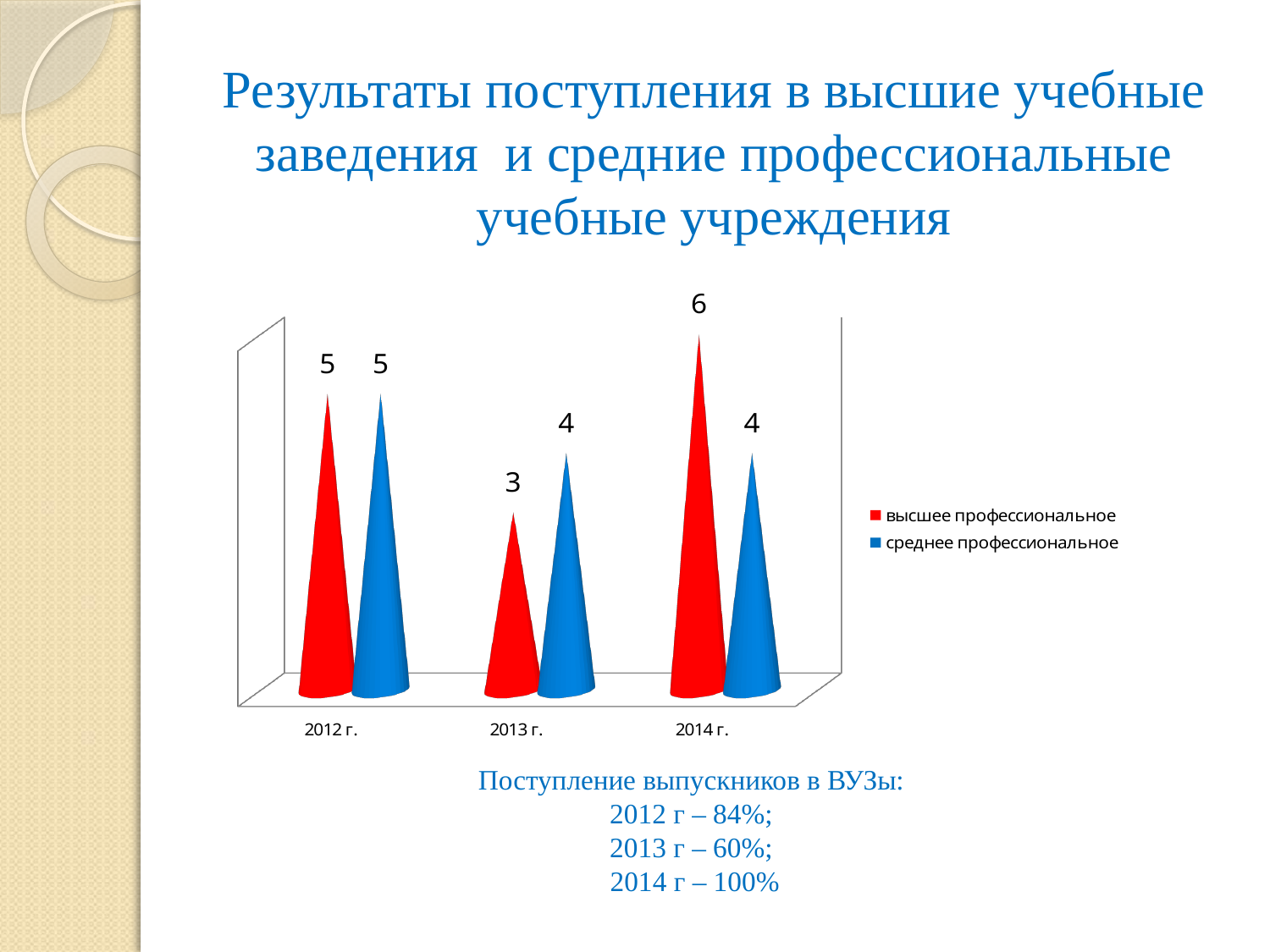
What is the value for "высшее профессиональное" in 2012 г.? 5 How many series does the legend list? 2 In which year is the value for "высшее профессиональное" highest? 2014 г. What kind of chart is shown on the slide? bar chart What is the value for "среднее профессиональное" in 2013 г.? 4 Does the value for "среднее профессиональное" rise or fall from 2012 г. to 2014 г.? fall How many years are shown on the x axis of the chart? 3 What is the difference between "высшее профессиональное" and "среднее профессиональное" in 2014 г.? 2 Which colour represents "высшее профессиональное" in the chart? red In which year is the value for "высшее профессиональное" lowest? 2013 г. In 2013 г., which is larger: "высшее профессиональное" or "среднее профессиональное"? среднее профессиональное What is the value for "высшее профессиональное" in 2014 г.? 6